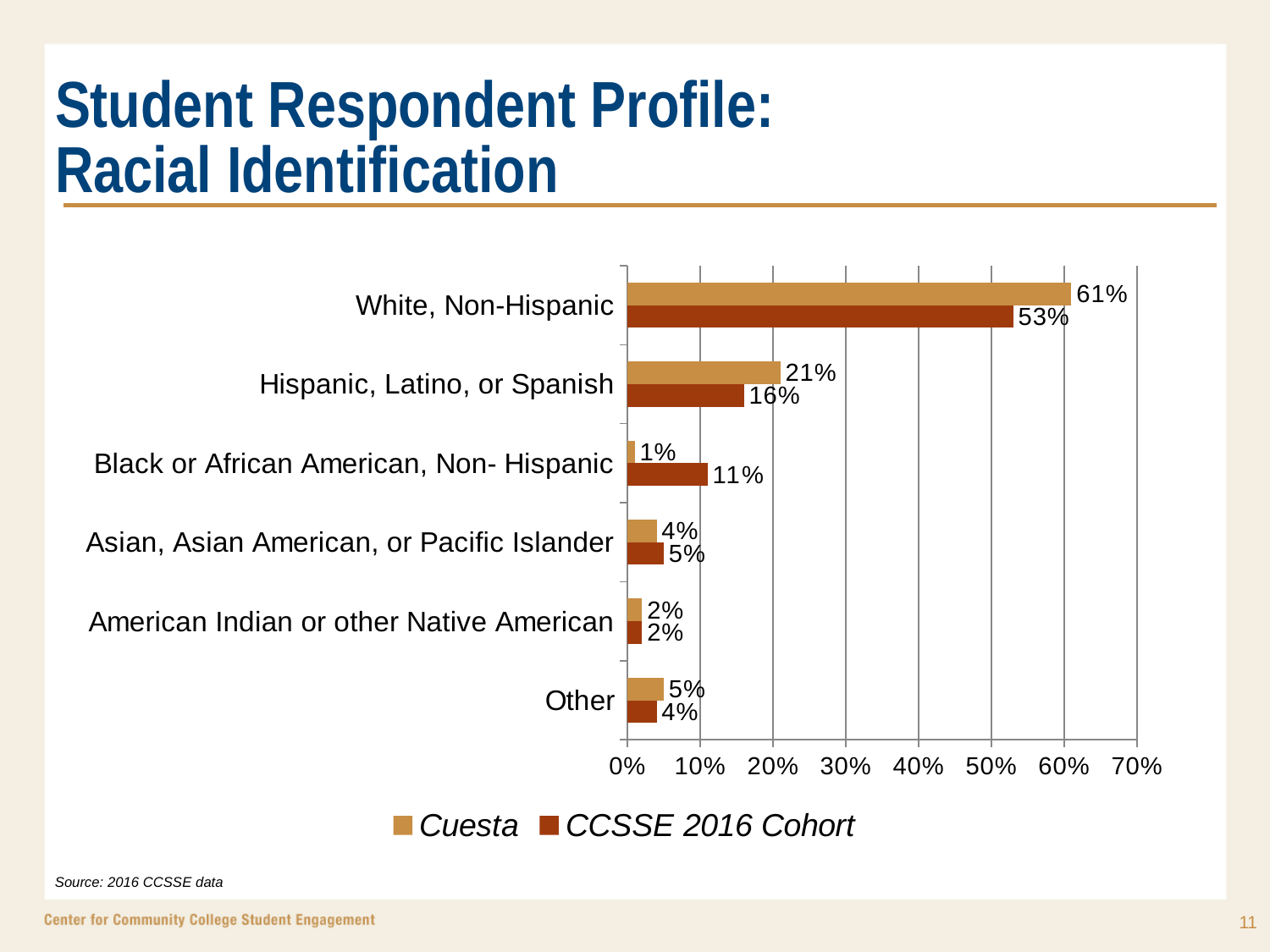
What is the CCSSE 2016 Cohort value for Black or African American, Non- Hispanic? 11% What is the Cuesta value for Hispanic, Latino, or Spanish? 21% What are the two series named in the legend? Cuesta and CCSSE 2016 Cohort What is the Cuesta value for White, Non-Hispanic? 61% How many series does the legend list? 2 How many racial categories are shown on the chart? 6 What is the difference between the Cuesta and CCSSE 2016 Cohort values for White, Non-Hispanic? 8% Which is larger for Black or African American, Non- Hispanic: the Cuesta value or the CCSSE 2016 Cohort value? CCSSE 2016 Cohort Which category has the highest Cuesta value? White, Non-Hispanic Which category has the lowest Cuesta value? Black or African American, Non- Hispanic Is the CCSSE 2016 Cohort value for White, Non-Hispanic greater or less than 50%? greater What kind of chart is shown on the slide? Bar chart